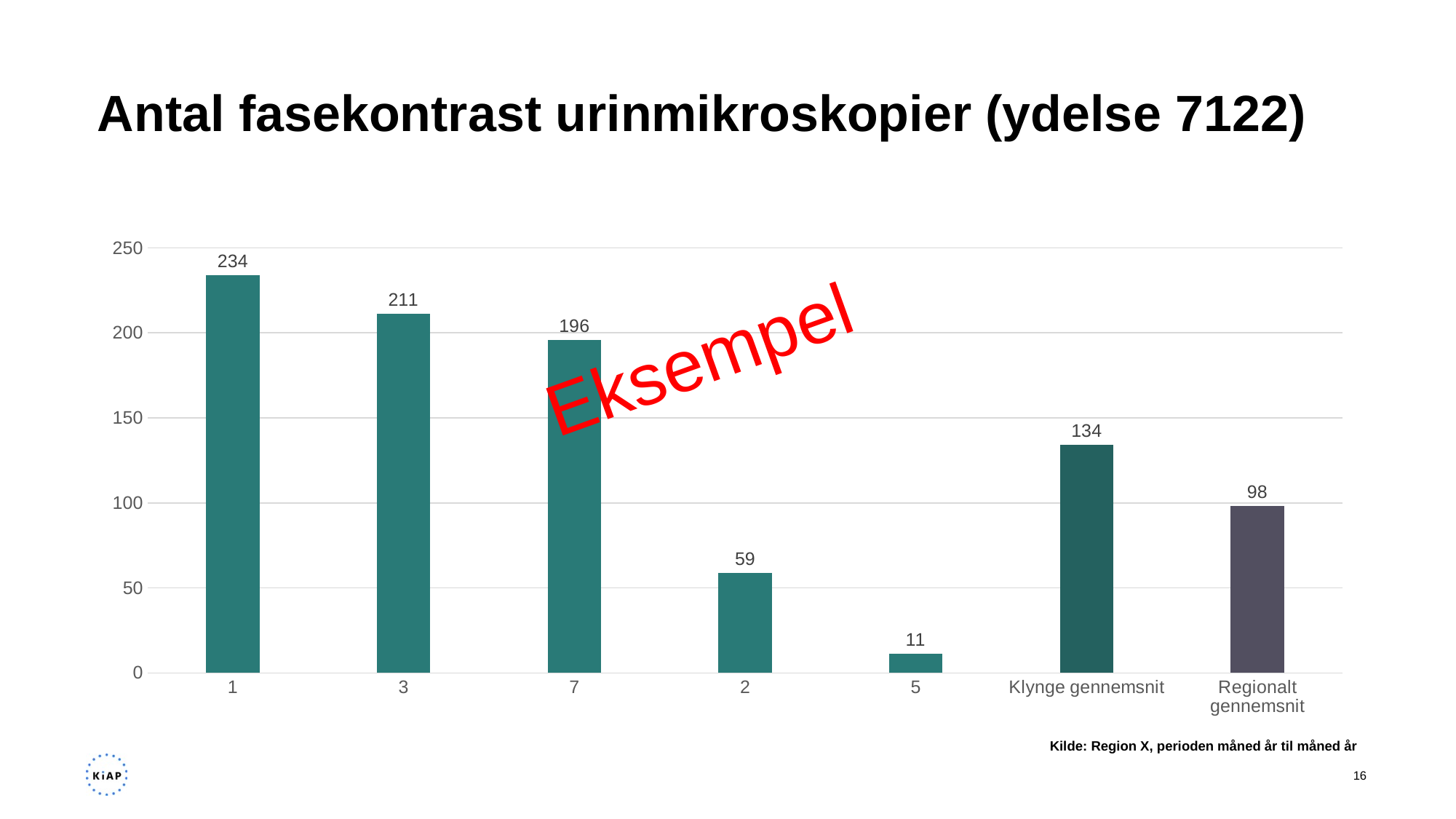
Which category has the highest value? 1 What is the title of the chart on the slide? Antal fasekontrast urinmikroskopier (ydelse 7122) What is the value for category 1? 234 Which is larger, the value for category 7 or the value for category 2? 7 What is the value for Klynge gennemsnit? 134 What is the value for Regionalt gennemsnit? 98 What is the difference between Klynge gennemsnit and Regionalt gennemsnit? 36 How many bars are shown in the chart? 7 Which category has the lowest value? 5 What kind of chart is shown on the slide? Bar chart What is the difference between the values for category 1 and category 3? 23 What is the value for category 5? 11